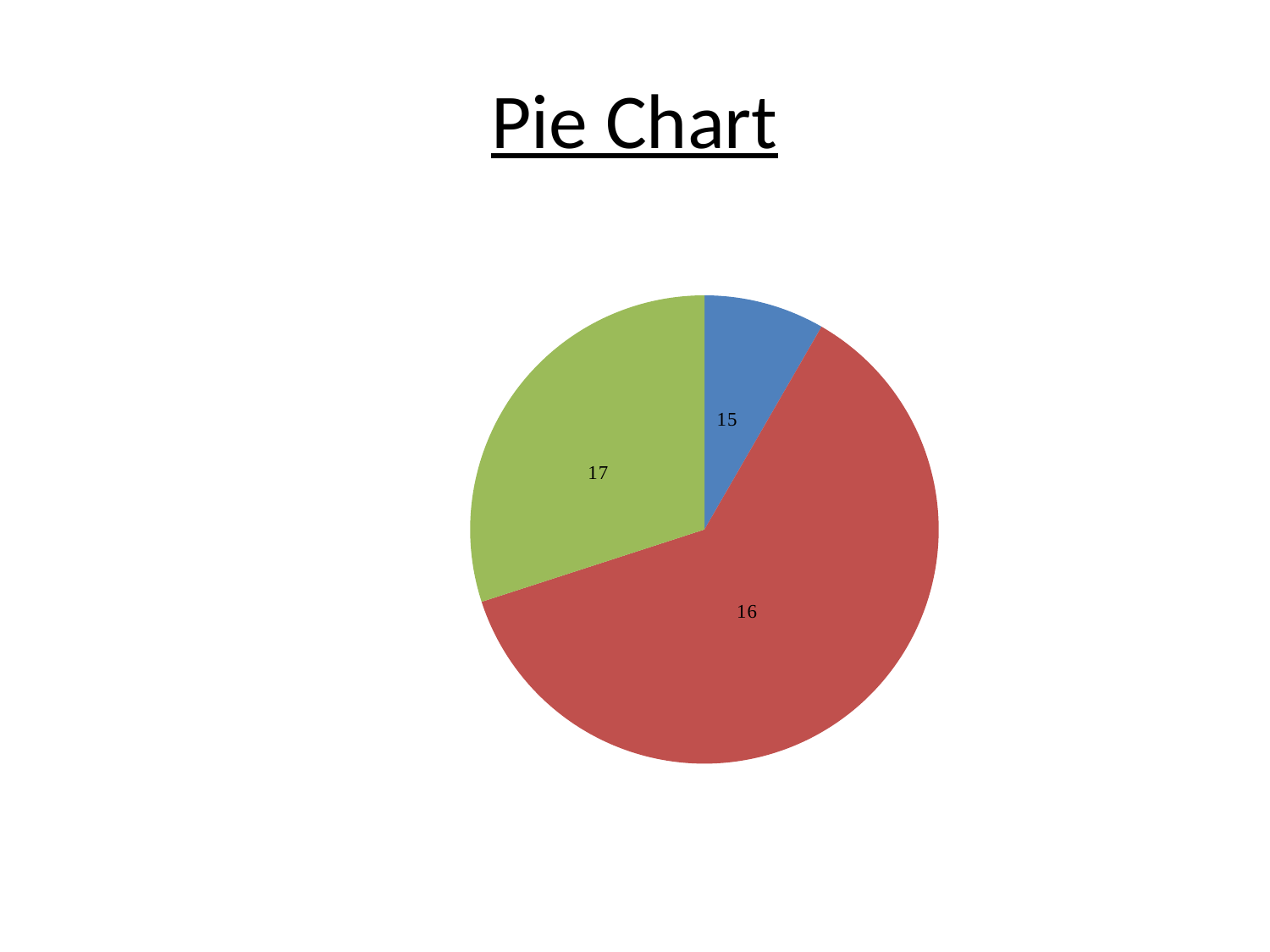
Which slice of the pie chart is the smallest? 15 How many slices does the pie chart have? 3 What kind of chart is shown on the slide? pie chart Which slice is larger, the one labelled 16 or the one labelled 17? 16 Which slice of the pie chart is the largest? 16 Which slice is larger, the one labelled 17 or the one labelled 15? 17 What colour is the largest slice of the pie chart? red What is the title of the slide? Pie Chart